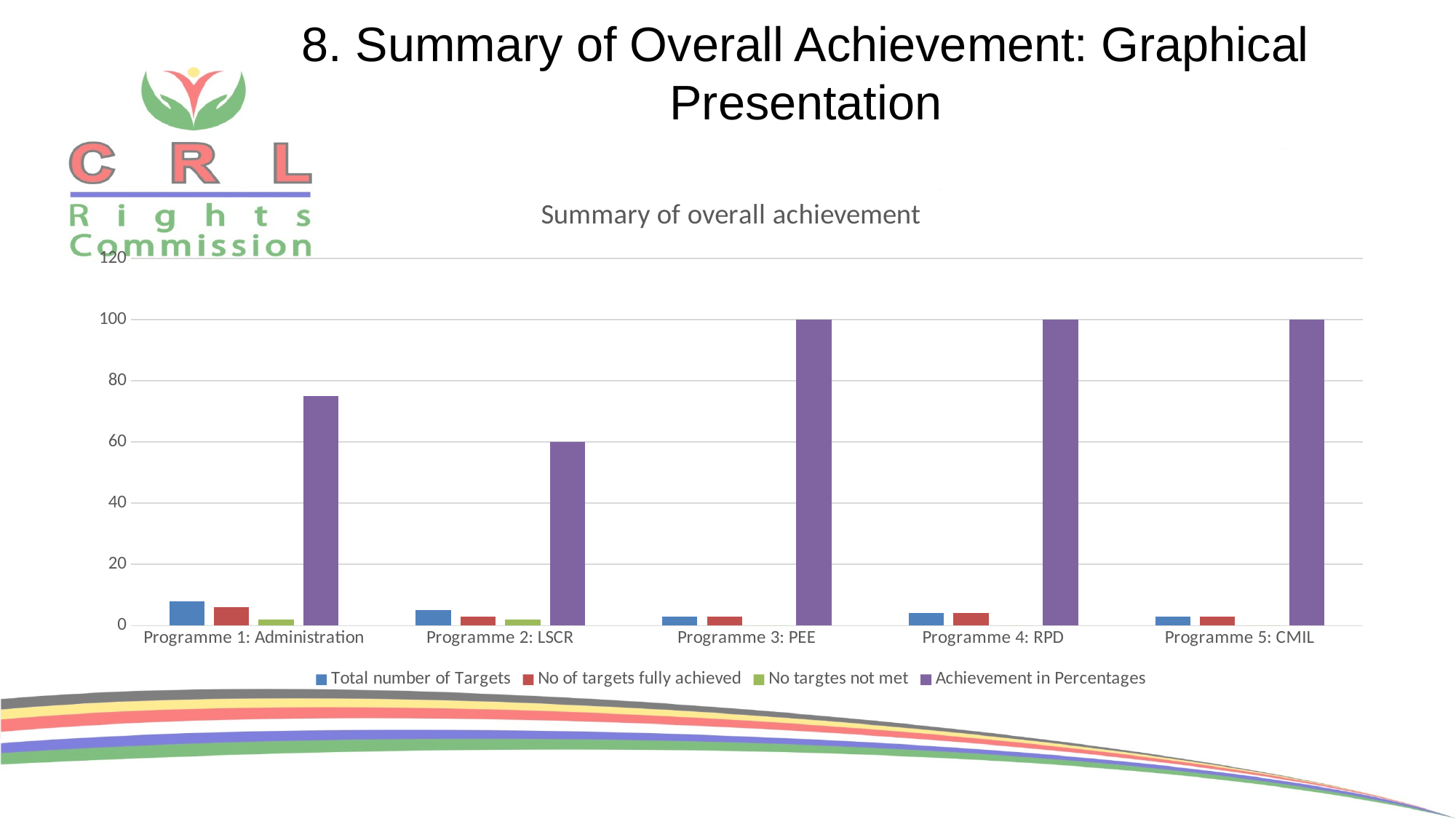
What type of chart is shown on the slide? bar chart What is the Achievement in Percentages value for Programme 2: LSCR? 60 What is the Achievement in Percentages value for Programme 5: CMIL? 100 Which has the larger Achievement in Percentages, Programme 1: Administration or Programme 2: LSCR? Programme 1: Administration What is the title of the chart? Summary of overall achievement Which programme has the lowest Achievement in Percentages? Programme 2: LSCR How many programmes are shown on the x axis? 5 What is the Achievement in Percentages value for Programme 3: PEE? 100 Is the Achievement in Percentages value for Programme 1: Administration greater or less than 60? greater Is the Total number of Targets for Programme 1: Administration greater or less than 20? less What is the difference in Achievement in Percentages between Programme 4: RPD and Programme 2: LSCR? 40 How many series does the legend list? 4